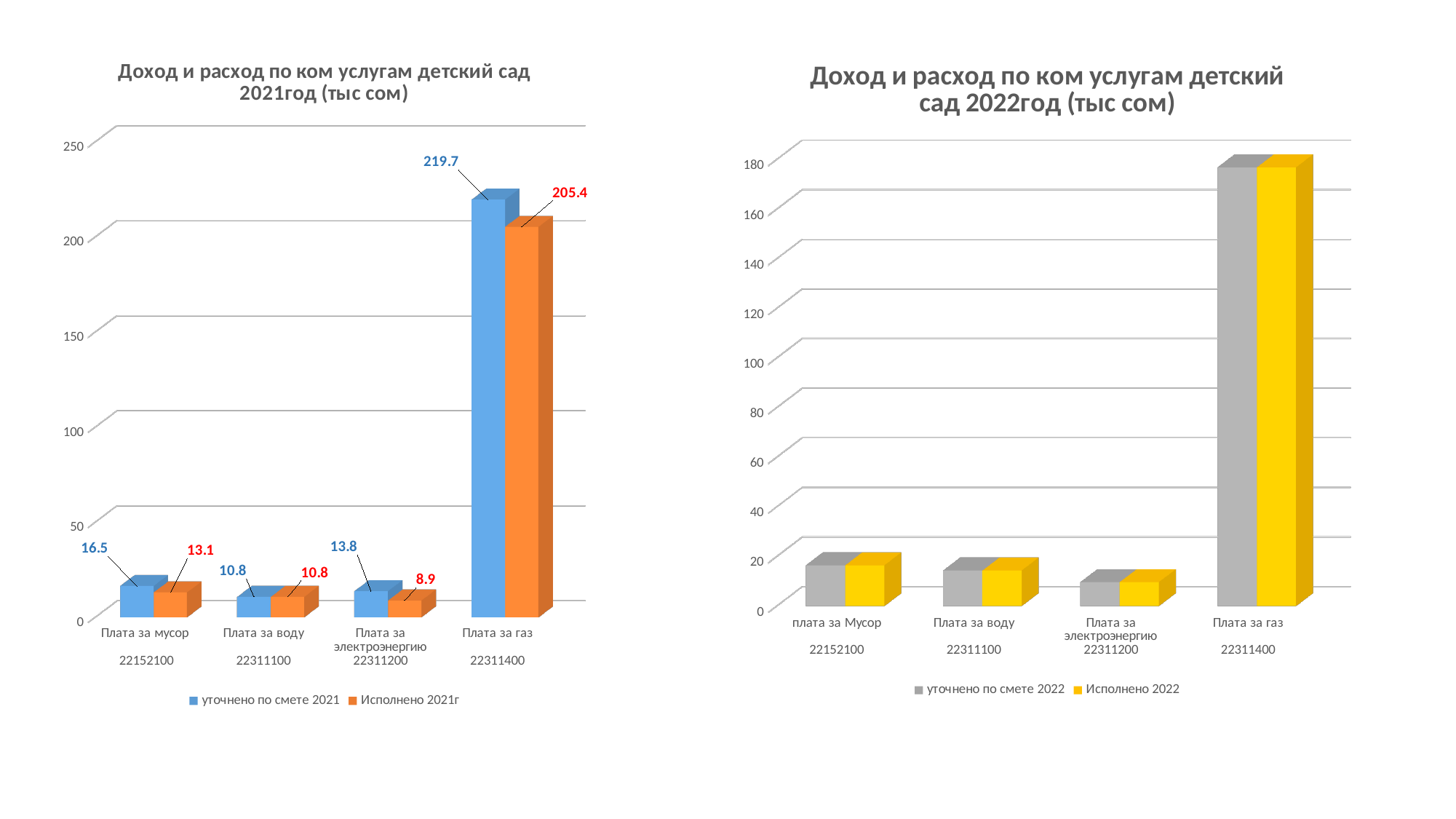
In the 2021 chart (left), which category has the highest 'уточнено по смете 2021' value? Плата за газ What kind of chart is the 2022 chart on the right? bar chart In the 2021 chart (left), what is the value of 'Исполнено 2021г' for 'Плата за электроэнергию'? 8.9 In the 2021 chart (left), how many series does the legend list? 2 In the 2022 chart (right), is the value of 'уточнено по смете 2022' for 'Плата за воду' greater or less than 20? less In the 2022 chart (right), how many categories are shown on the x axis? 4 In the 2021 chart (left), which is larger for 'Плата за мусор': 'уточнено по смете 2021' or 'Исполнено 2021г'? уточнено по смете 2021 In the 2021 chart (left), which category has the lowest 'Исполнено 2021г' value? Плата за электроэнергию In the 2021 chart (left), what is the value of 'уточнено по смете 2021' for 'Плата за газ'? 219.7 In the 2021 chart (left), what is the difference between 'уточнено по смете 2021' and 'Исполнено 2021г' for 'Плата за газ'? 14.3 In the 2022 chart (right), is the value of 'Исполнено 2022' for 'Плата за газ' greater or less than 160? greater In the 2021 chart (left), what is the value of 'Исполнено 2021г' for 'Плата за мусор'? 13.1